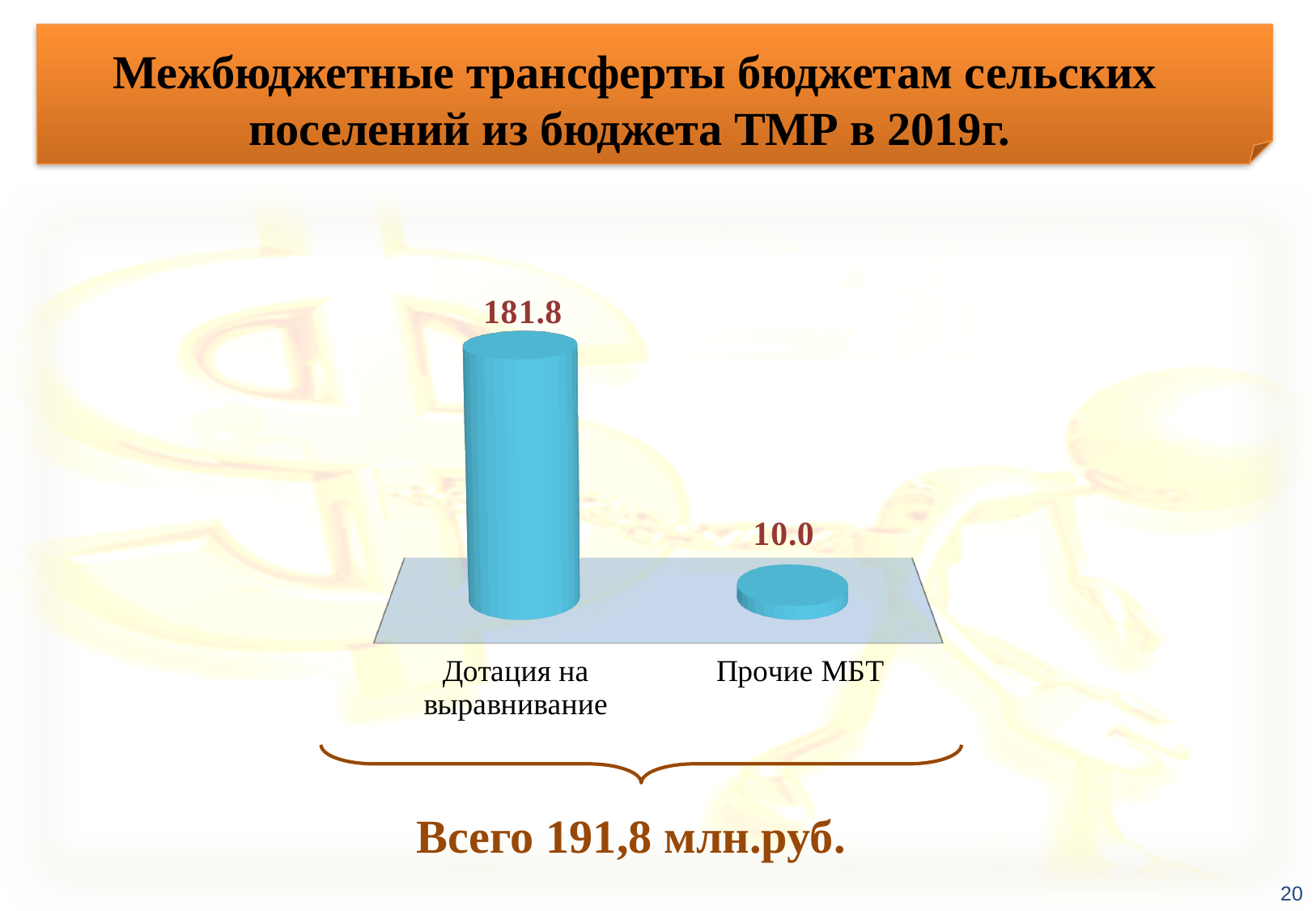
How many categories are shown in the chart? 2 Which category has the highest value? Дотация на выравнивание What is the difference between the values for "Дотация на выравнивание" and "Прочие МБТ"? 171.8 What is the title of the slide? Межбюджетные трансферты бюджетам сельских поселений из бюджета ТМР в 2019г. What is the value for "Прочие МБТ"? 10.0 What is the value for "Дотация на выравнивание"? 181.8 What kind of chart is shown on the slide? Bar chart What is the total of the two values shown in the chart? 191.8 Which category has the lowest value? Прочие МБТ What total amount is stated below the chart? Всего 191,8 млн.руб. Which is larger: the value for "Дотация на выравнивание" or for "Прочие МБТ"? Дотация на выравнивание